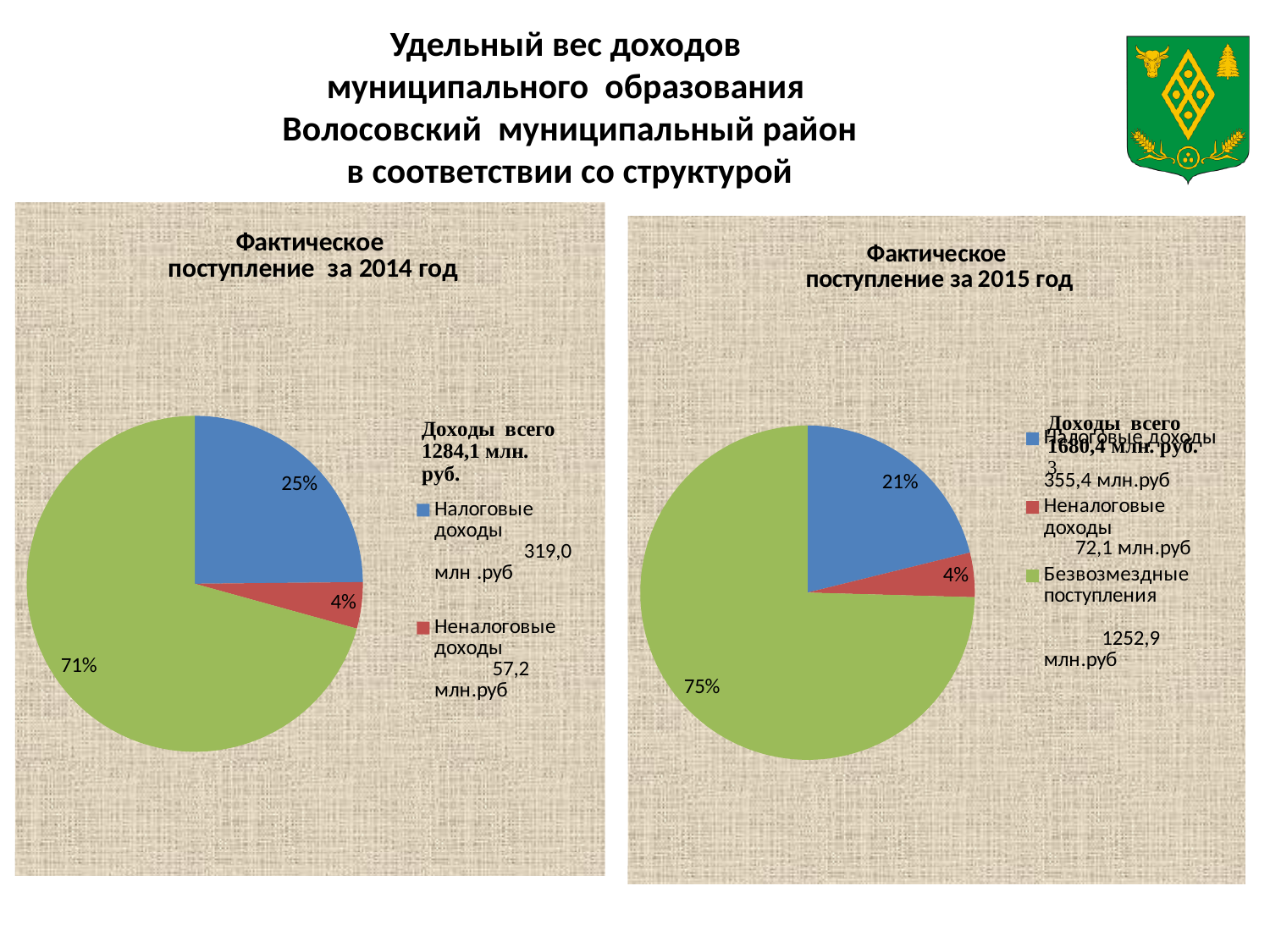
In the chart "Фактическое поступление за 2015 год", which category has the smallest slice? Неналоговые доходы In the chart "Фактическое поступление за 2015 год", what value in млн.руб is given for Налоговые доходы? 355,4 млн.руб In the chart "Фактическое поступление за 2014 год", what value in млн.руб is given for Неналоговые доходы? 57,2 млн.руб In the chart "Фактическое поступление за 2015 год", what share of the pie is Налоговые доходы? 21% In the chart "Фактическое поступление за 2014 год", what share of the pie is Налоговые доходы? 25% In the chart "Фактическое поступление за 2014 год", what share of the pie is Неналоговые доходы? 4% In the chart "Фактическое поступление за 2015 год", which category has the largest slice? Безвозмездные поступления In the chart "Фактическое поступление за 2015 год", how many slices does the pie have? 3 What type of chart is shown under the title "Фактическое поступление за 2014 год"? pie chart In the chart "Фактическое поступление за 2015 год", what is the difference in percentage points between Безвозмездные поступления and Налоговые доходы? 54 In the chart "Фактическое поступление за 2014 год", what is the share of the largest slice? 71%